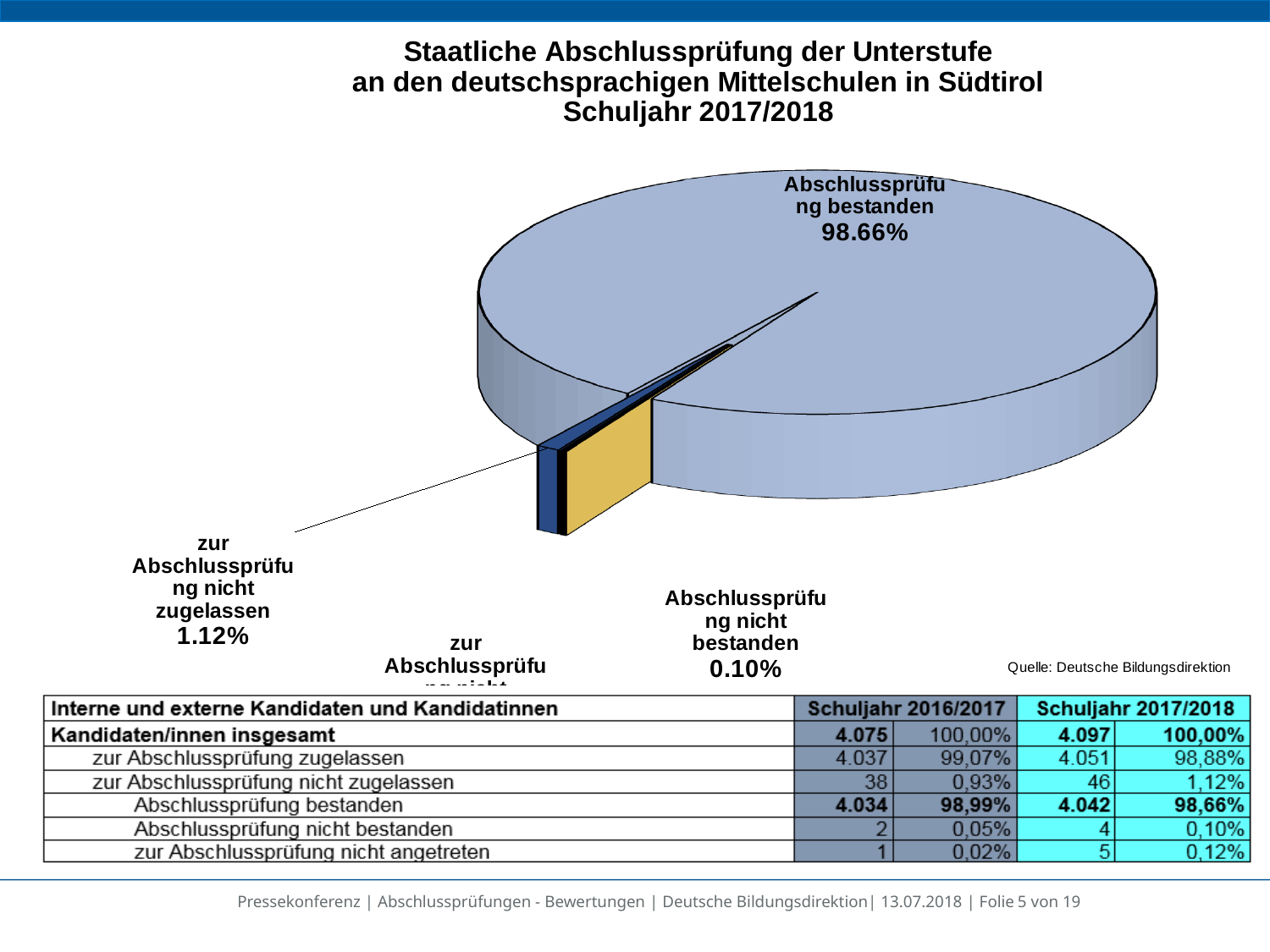
Which is larger: the slice for "zur Abschlussprüfung nicht zugelassen" or the slice for "Abschlussprüfung nicht bestanden"? zur Abschlussprüfung nicht zugelassen What share of the pie does "Abschlussprüfung bestanden" represent? 98.66% Which school year does the pie chart's title refer to? Schuljahr 2017/2018 What is the difference in percentage points between the "Abschlussprüfung bestanden" slice and the "zur Abschlussprüfung nicht zugelassen" slice? 97.54 What colour is the slice for "zur Abschlussprüfung nicht zugelassen"? yellow How many slices does the pie chart have? 4 What share of the pie does "zur Abschlussprüfung nicht zugelassen" represent? 1.12% What kind of chart is shown on the slide? pie chart What is the difference in percentage points between the "zur Abschlussprüfung nicht zugelassen" slice and the "Abschlussprüfung nicht bestanden" slice? 1.02 Which slice of the pie chart is the largest? Abschlussprüfung bestanden What share of the pie does "Abschlussprüfung nicht bestanden" represent? 0.10%